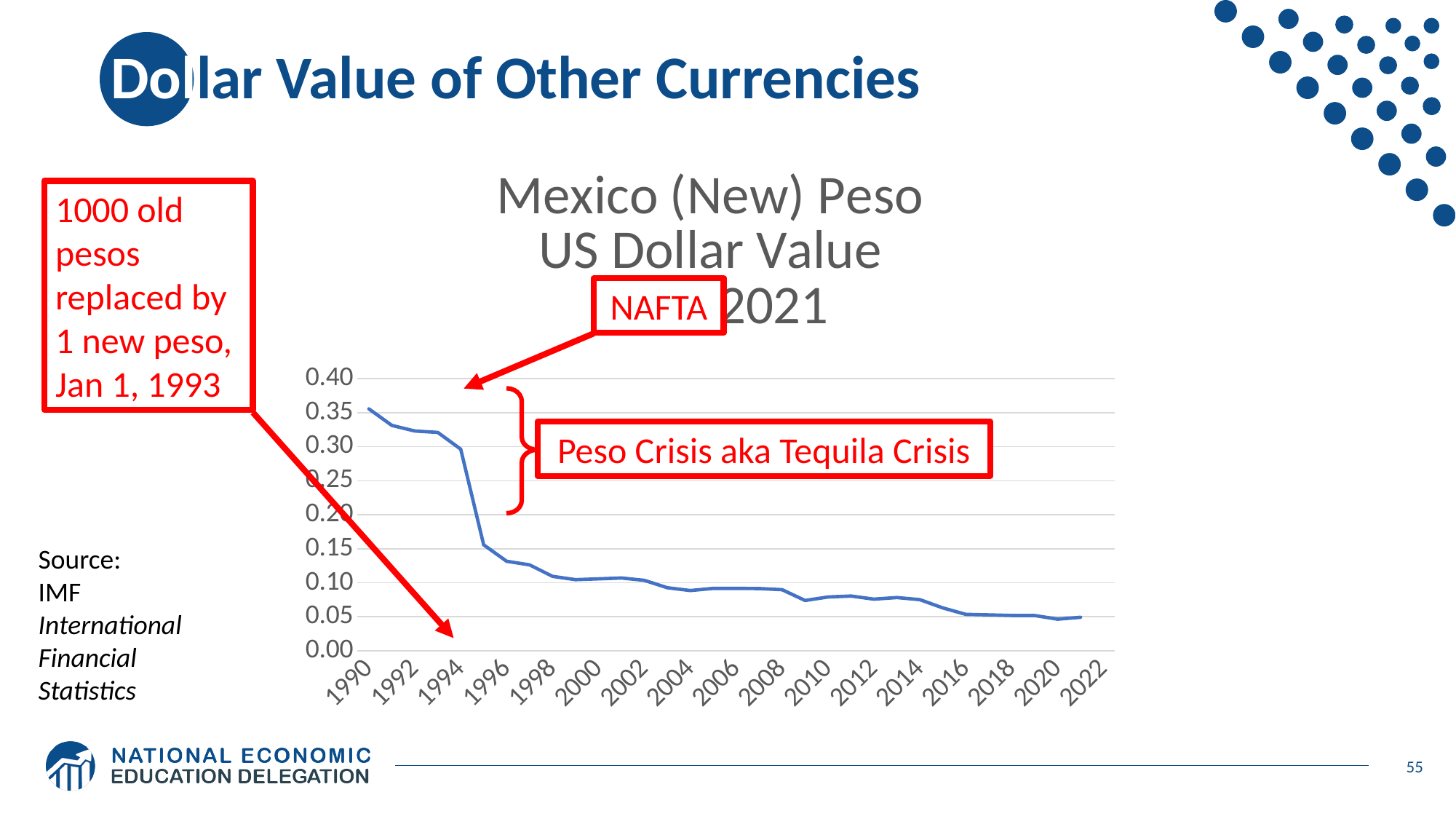
What kind of chart is shown on the slide? line chart Overall, does the US dollar value of the Mexican peso rise or fall from 1990 to 2021? fall Is the value for 2020 greater or less than 0.10? less What event does the red annotation label the sharp drop in the peso's value after 1994? Peso Crisis aka Tequila Crisis Which year has a higher US dollar value of the peso, 1994 or 1996? 1994 What is the title of the chart? Mexico (New) Peso US Dollar Value 1990-2021 Is the value for 2000 greater or less than 0.15? less Which year has a higher US dollar value of the peso, 2008 or 2016? 2008 Is the value for 1996 greater or less than 0.15? less How many year labels are shown on the x axis? 17 In which year shown is the US dollar value of the peso highest? 1990